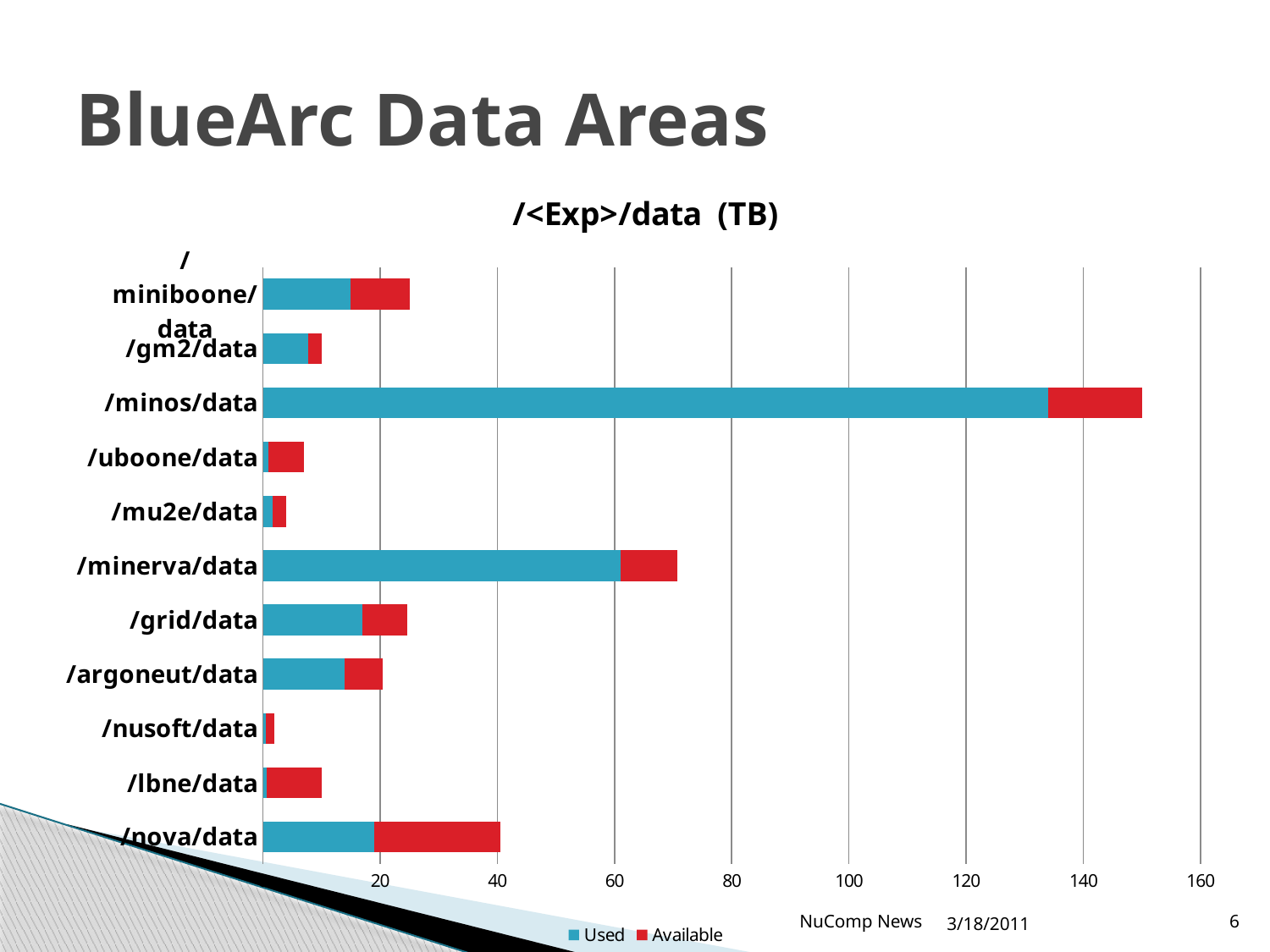
Which series is shown in red in the legend? Available Which data area has the largest total bar? /minos/data What kind of chart is shown on the slide? stacked bar chart What is the title of the chart? /<Exp>/data (TB) How many data areas (categories) are plotted on the chart? 11 Which has a larger total bar, /minerva/data or /grid/data? /minerva/data Is the total value for /minos/data greater or less than 140? greater Is the total value for /miniboone/data greater or less than 40? less How many series does the legend list? 2 Is the Used value for /minos/data greater or less than 120? greater Which data area has the smallest total bar? /nusoft/data